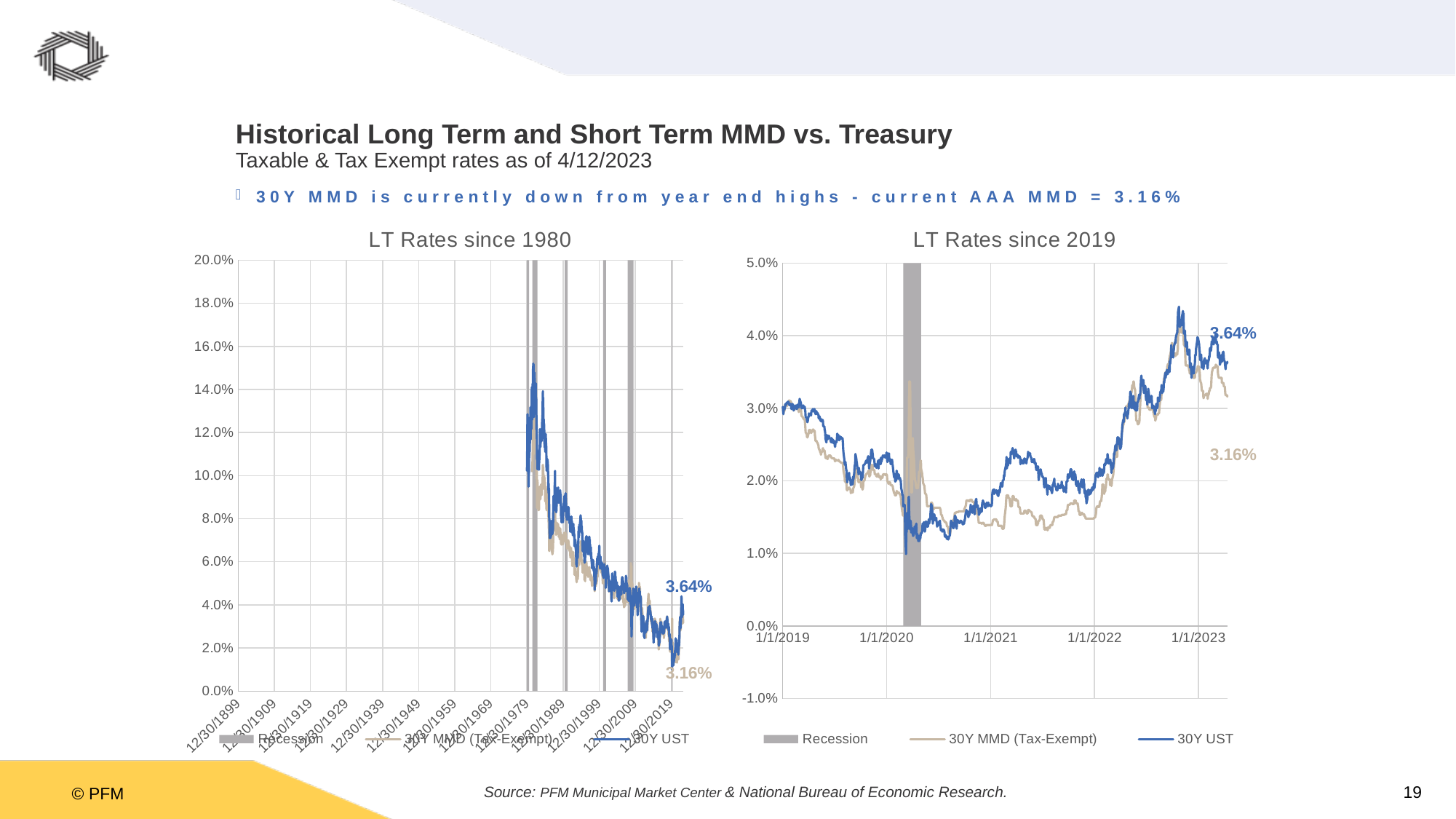
In the "LT Rates since 1980" chart, do the 30Y UST rates generally rise or fall from the early 1980s to 2019? fall In the "LT Rates since 2019" chart, which series reaches the highest value? 30Y UST In the "LT Rates since 2019" chart, is the lowest value of 30Y UST during 2020 greater or less than 1.5%? less In the "LT Rates since 2019" chart, is the peak value of 30Y UST greater or less than 4.0%? greater How many entries does the legend of the "LT Rates since 1980" chart list? 3 In the "LT Rates since 2019" chart, what is the labeled current value of 30Y UST? 3.64% In the "LT Rates since 2019" chart, what is the difference between the labeled 30Y UST value and the labeled 30Y MMD (Tax-Exempt) value? 0.48% In the "LT Rates since 2019" chart, what is the labeled current value of 30Y MMD (Tax-Exempt)? 3.16% What kind of chart is "LT Rates since 2019"? line chart What is the title of the chart on the left side of the slide? LT Rates since 1980 In the "LT Rates since 1980" chart, is the peak value of 30Y UST greater or less than 14.0%? greater In the "LT Rates since 2019" chart, which series has the higher labeled current value, 30Y UST or 30Y MMD (Tax-Exempt)? 30Y UST